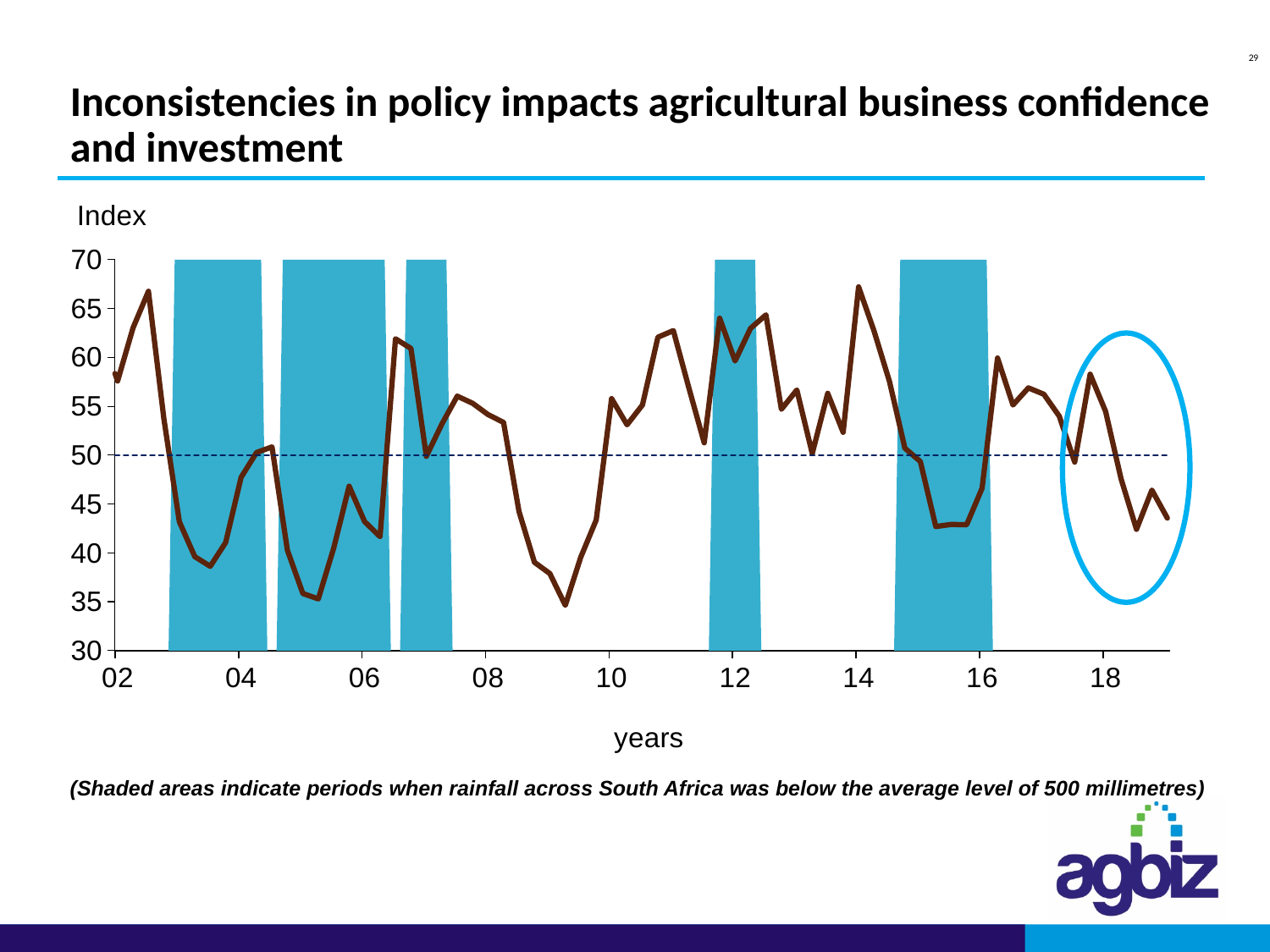
Does the index rise or fall between 2009 and 2010? rise Is the peak value of the index around 2014 greater or less than 65? greater What is the label of the vertical axis? Index Is the final value of the index at the end of the series (after 2018) greater or less than 50? less What is the label of the horizontal axis? years Does the index rise or fall between 2008 and 2009? fall Is the lowest value of the index around 2009 greater or less than 40? less What kind of chart is shown on the slide? line chart What is the highest value shown on the vertical axis? 70